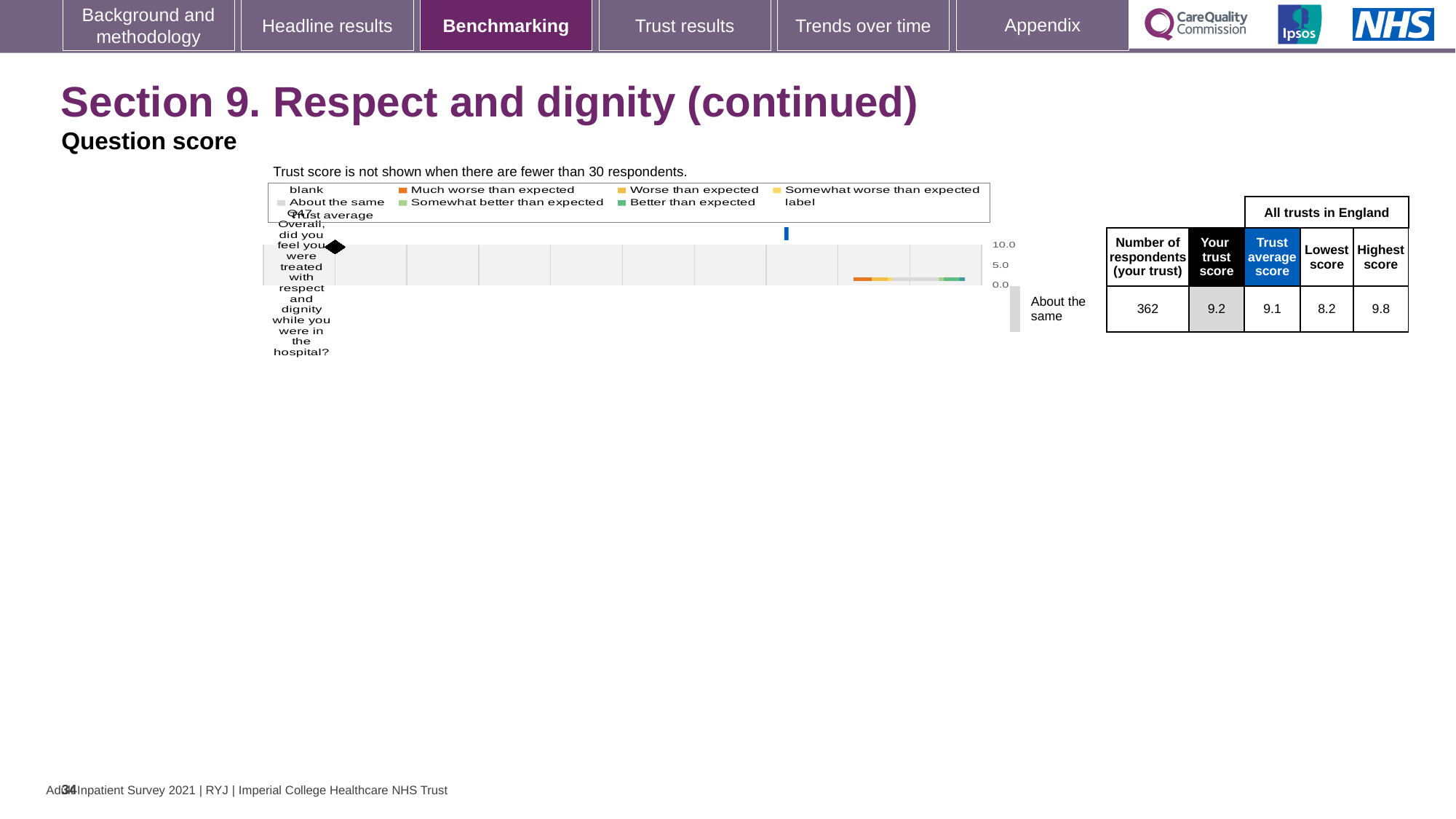
Which benchmark category is your trust's Q47 score placed in? About the same Is your trust score for Q47 greater or less than 5.0? greater What is the 'Your trust score' value for Q47 (Overall, did you feel you were treated with respect and dignity while you were in the hospital?)? 9.2 How many respondents from your trust answered Q47? 362 What is the Trust average score shown for Q47? 9.1 What is the Lowest score among all trusts in England for Q47? 8.2 What is the Highest score among all trusts in England for Q47? 9.8 Which question number is plotted on the chart? Q47 What is the highest tick value shown on the chart's score axis? 10.0 What is the difference between your trust score and the trust average score for Q47? 0.1 Which is larger for Q47: your trust score or the trust average score? Your trust score What is the difference between the highest score and the lowest score for Q47? 1.6